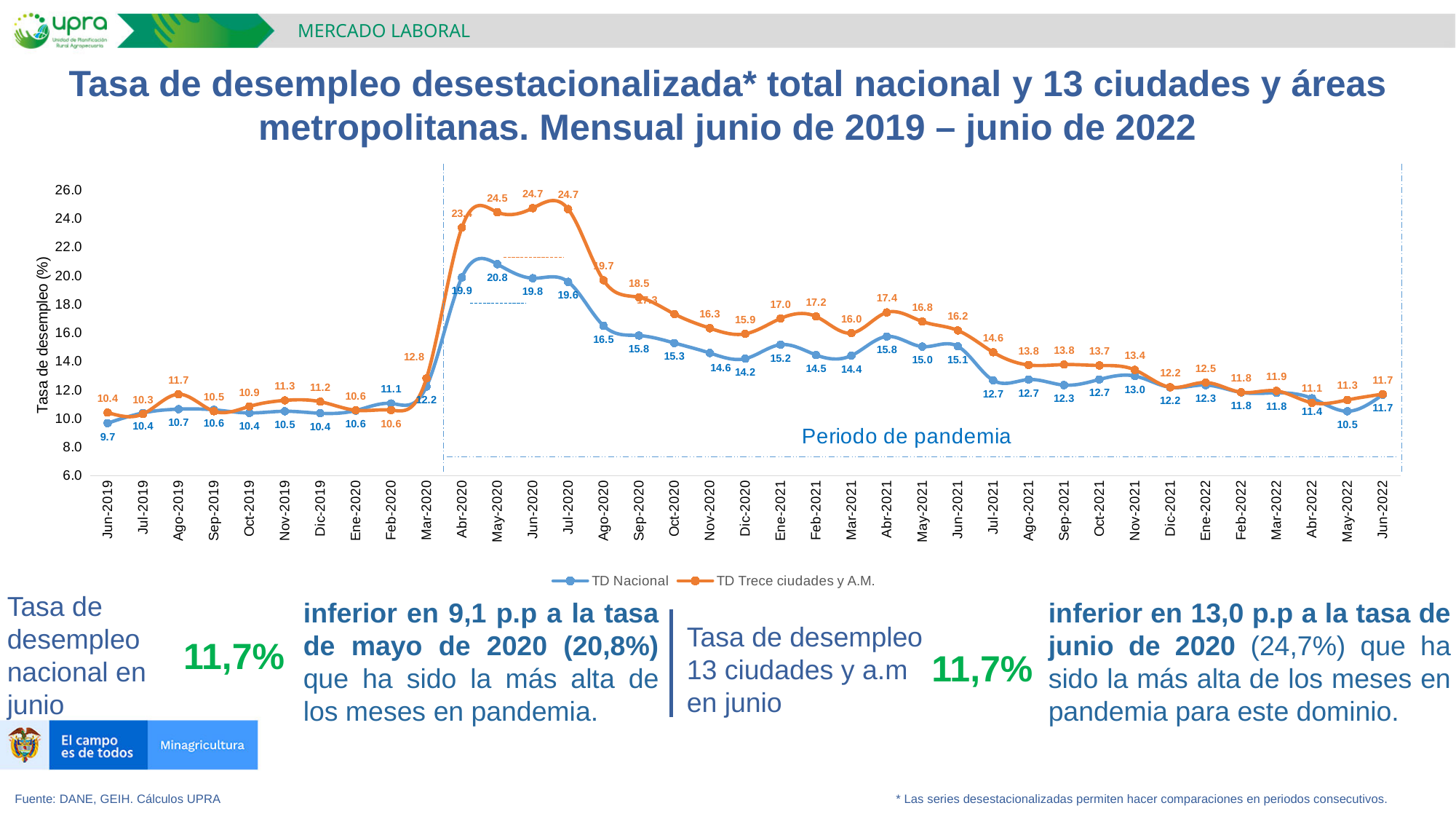
What is the value of TD Trece ciudades y A.M. in Jun-2022? 11.7 How many months are plotted on the x axis? 37 In which month is TD Nacional at its lowest value? Jun-2019 What kind of chart is shown on the slide? Line chart In which month does TD Nacional reach its highest value? May-2020 What is the value of TD Nacional in May-2020? 20.8 Which series has the higher value in Abr-2021, TD Nacional or TD Trece ciudades y A.M.? TD Trece ciudades y A.M. How many series does the legend list? 2 Does TD Nacional rise or fall from Jun-2021 to Jul-2021? Fall What is the value of TD Nacional in Jun-2019? 9.7 What is the difference between TD Trece ciudades y A.M. and TD Nacional in May-2020? 3.7 Is the value of TD Trece ciudades y A.M. in Jun-2020 greater or less than 22.0? greater